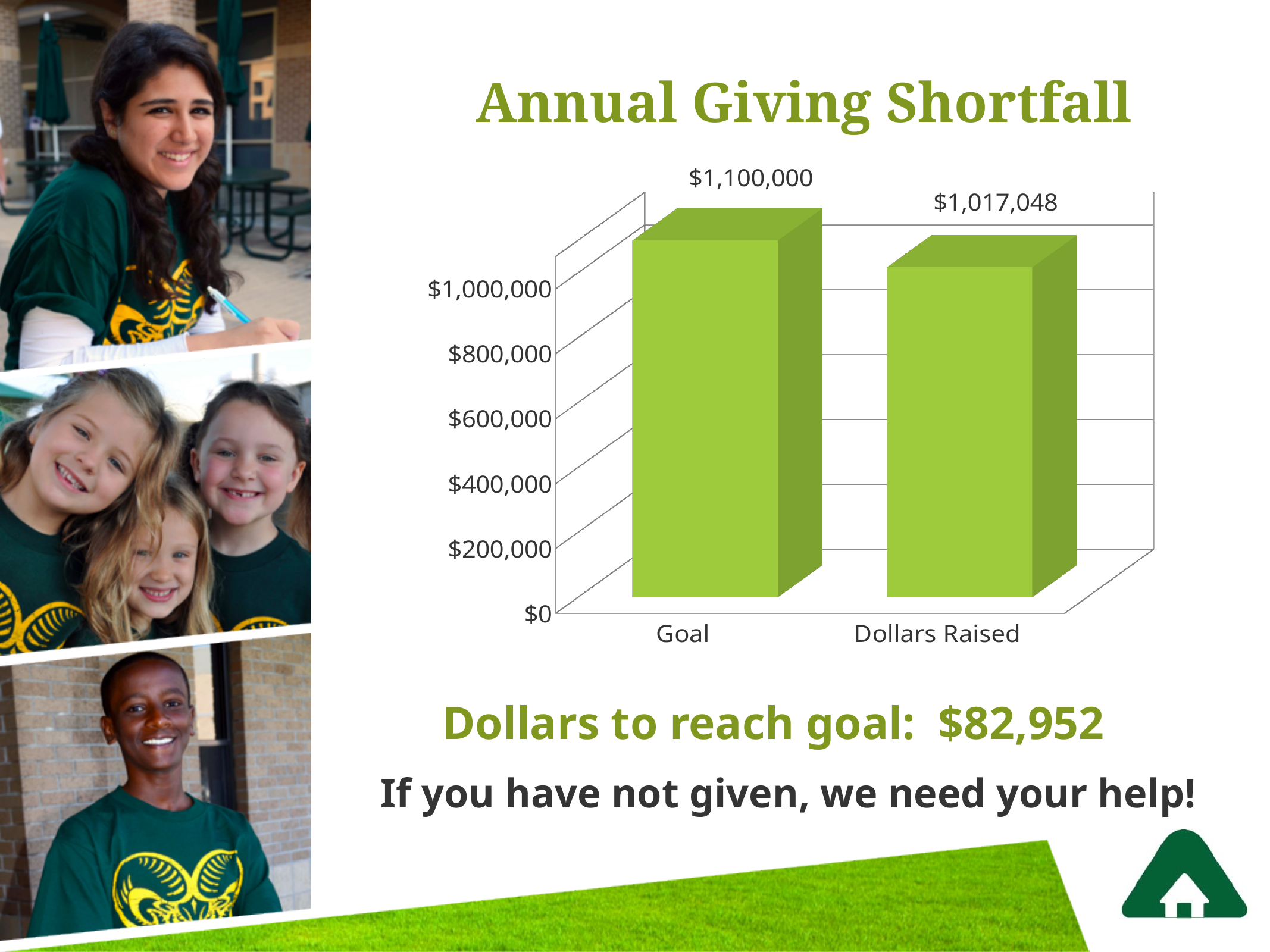
Is the value for Goal larger or smaller than the value for Dollars Raised? larger What is the title of the chart? Annual Giving Shortfall What is the value of the Goal bar? $1,100,000 Which category has the higher value? Goal Which category has the lower value? Dollars Raised What kind of chart is shown on the slide? bar chart What is the difference between the Goal and Dollars Raised values? $82,952 What colour are the bars in the chart? green Is the value for Goal greater or less than $800,000? greater How many categories are shown on the chart? 2 What is the value of the Dollars Raised bar? $1,017,048 Is the value for Dollars Raised greater or less than $1,000,000? greater